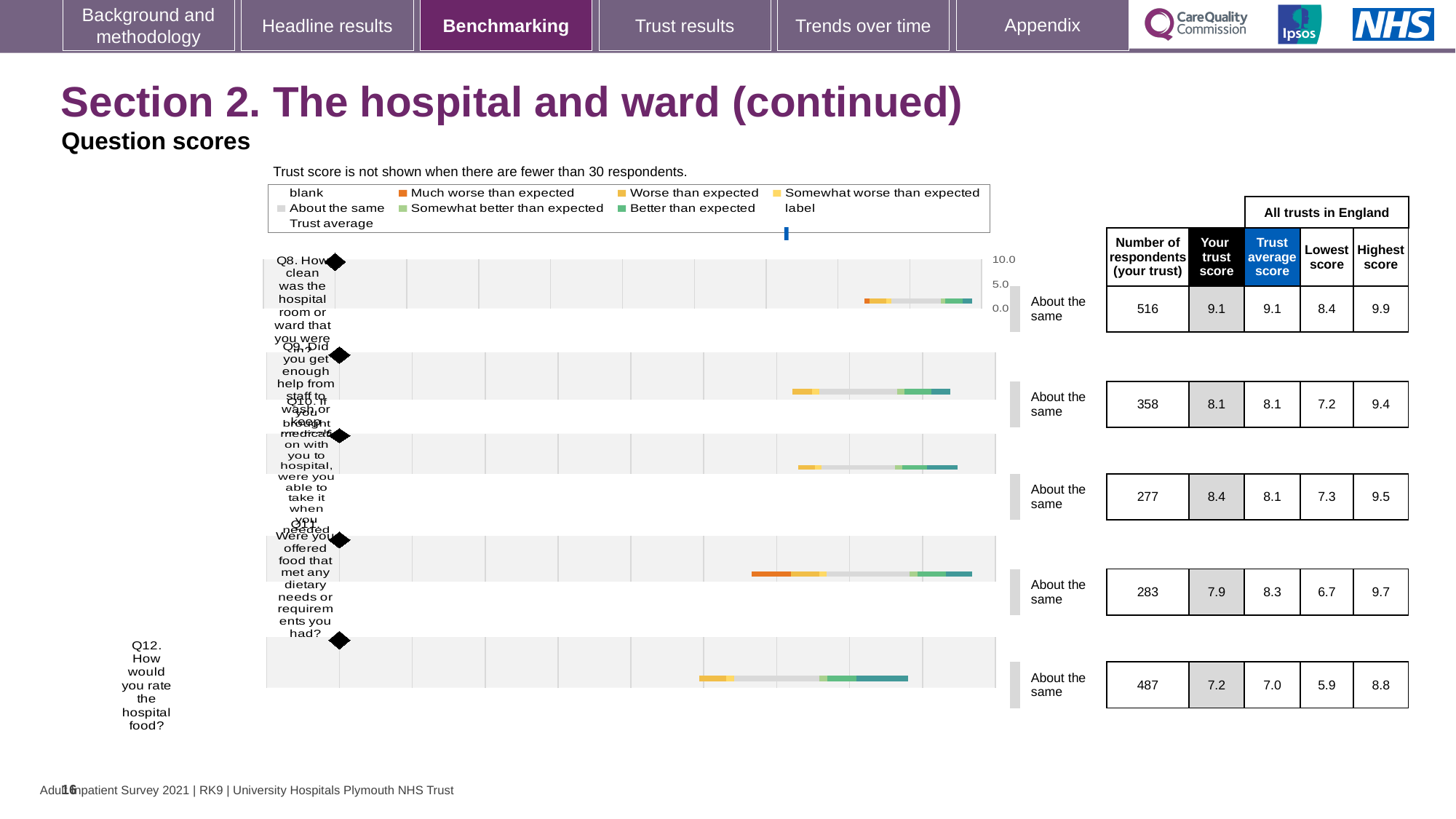
What is the lowest score across all trusts in England for Q11 (offered food that met dietary needs)? 6.7 How many questions (categories) are plotted in the chart? 5 What kind of chart is used to show the question scores on this slide? bar chart What is the 'Your trust score' value for Q8 (how clean was the hospital room or ward)? 9.1 For Q8, what is the difference between the highest score and the lowest score across all trusts in England? 1.5 Which question has the lowest 'Your trust score'? Q12 What is the number of respondents for Q12 (how would you rate the hospital food)? 487 What benchmark category is shown for Q11? About the same According to the note above the chart, when is the trust score not shown? When there are fewer than 30 respondents For Q10, which is larger: the 'Your trust score' or the 'Trust average score'? Your trust score Which question has the highest 'Your trust score'? Q8 What is the highest score across all trusts in England for Q10 (medication brought with you to hospital)? 9.5